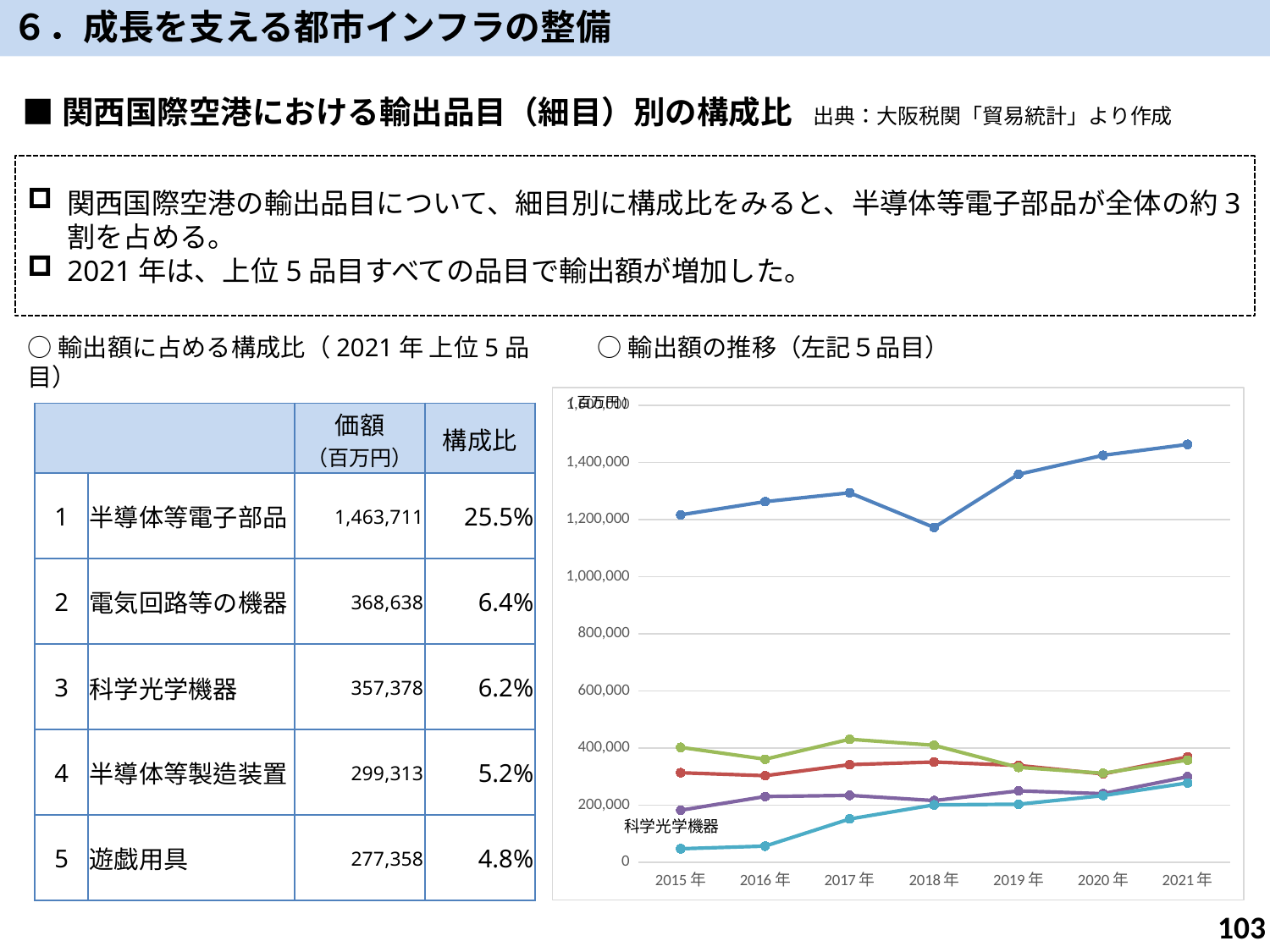
In the 「輸出額の推移」 chart, is the value of the lowest line in 2015年 greater or less than 200,000? less In the 「輸出額の推移」 chart, does the top line rise or fall from 2019年 to 2021年? rise What is the first year shown on the x axis of the 「輸出額の推移」 chart? 2015年 In the 「輸出額の推移」 chart, is the value of the top line in 2018年 greater or less than 1,000,000? greater In the 「輸出額の推移」 chart, which is higher in 2015年: the green line or the red line? the green line How many years are shown on the x axis of the 「輸出額の推移」 chart? 7 In the 「輸出額の推移」 chart, is the value of the top line in 2021年 greater or less than 1,400,000? greater How many lines are plotted in the 「輸出額の推移」 chart? 5 In the 「輸出額の推移」 chart, in which year does the top line reach its highest point? 2021年 What kind of chart is shown under 「輸出額の推移（左記5品目）」? line chart In the 「輸出額の推移」 chart, in which year does the top line reach its lowest point? 2018年